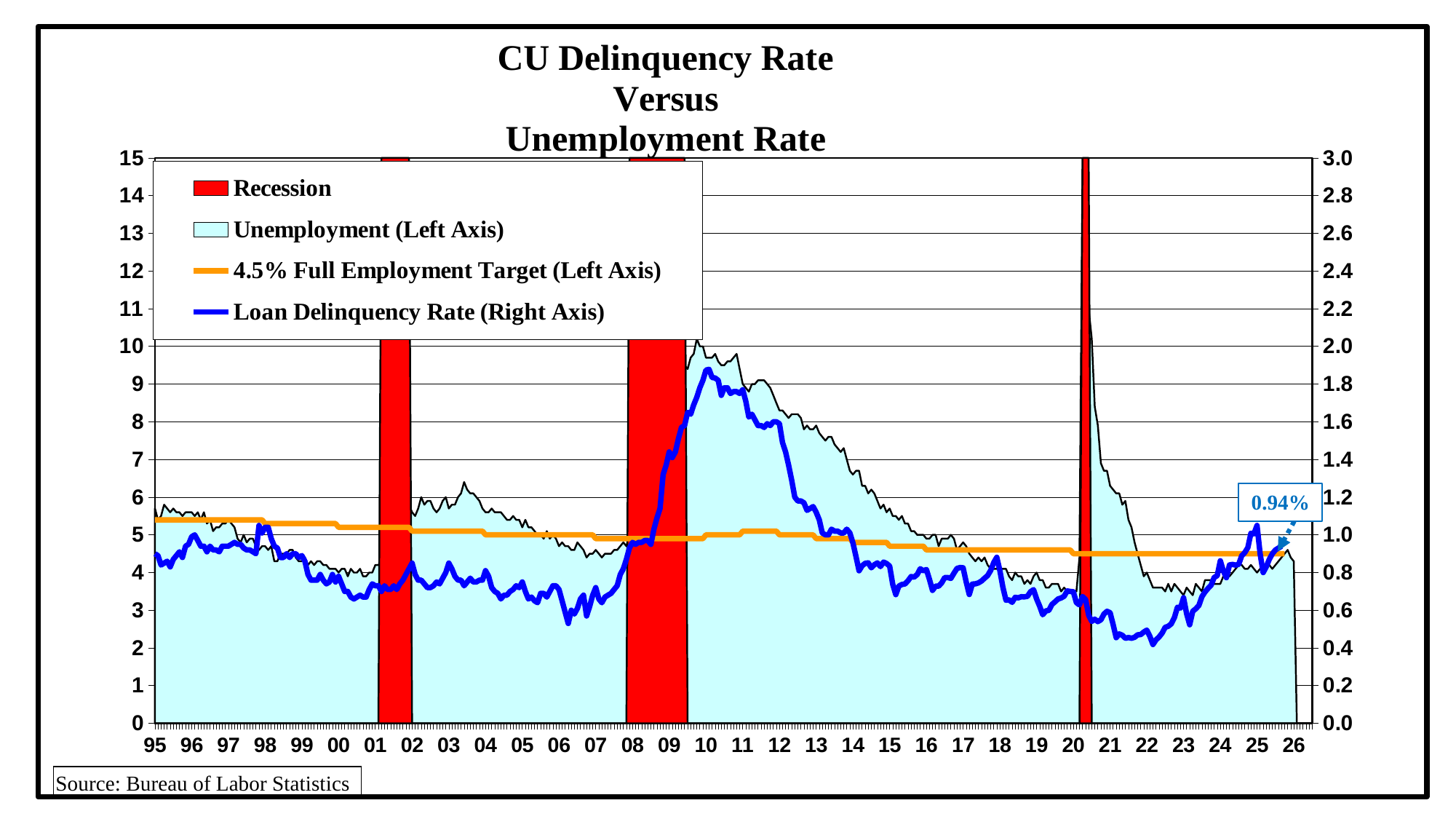
Does the unemployment rate rise or fall between 2010 and 2019? fall Is the Loan Delinquency Rate low point around 2022 greater or less than 0.6 on the right axis? less What is the title of the chart? CU Delinquency Rate Versus Unemployment Rate In which year does the unemployment rate reach its highest point on the chart? 2020 How many recession periods are shaded on the chart? 3 Does the Loan Delinquency Rate rise or fall between 2022 and 2025? rise What is the most recent Loan Delinquency Rate value labeled on the chart? 0.94% How many entries does the chart's legend list? 4 What value is the Full Employment Target line set at, according to the legend? 4.5% Is the peak unemployment rate around 2020 greater or less than 12 on the left axis? greater Which axis is the Loan Delinquency Rate plotted against? Right axis Is the peak Loan Delinquency Rate around 2010 greater or less than 1.6 on the right axis? greater